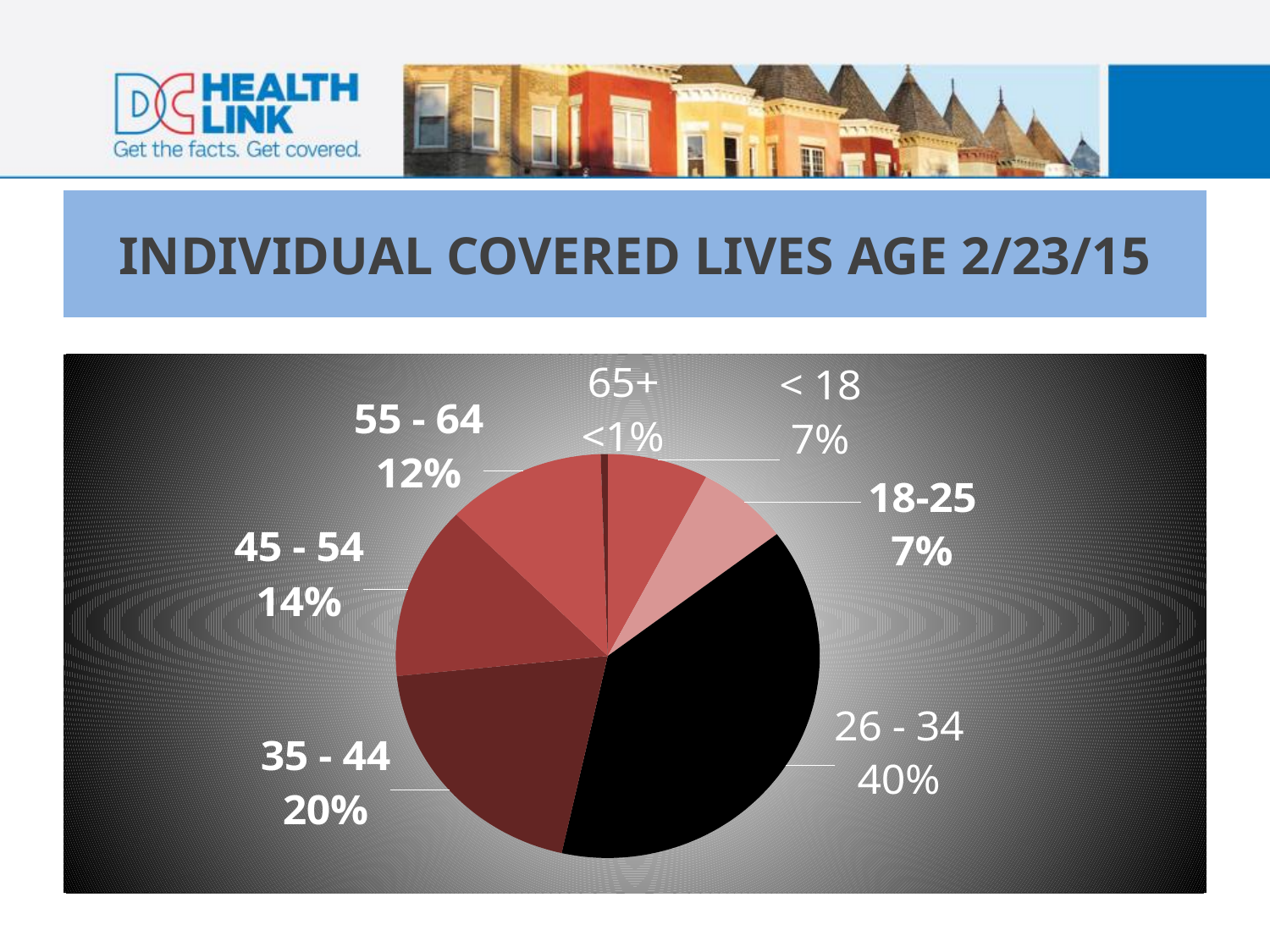
What is the title of the slide containing the pie chart? INDIVIDUAL COVERED LIVES AGE 2/23/15 What share of individual covered lives is in the 45 - 54 age group? 14% Which age group has a larger share, 45 - 54 or 55 - 64? 45 - 54 What share of individual covered lives is in the 26 - 34 age group? 40% What share of individual covered lives is in the 55 - 64 age group? 12% What is the difference in percentage points between the 26 - 34 and 35 - 44 age groups? 20 Which age group has the largest share of individual covered lives? 26 - 34 What kind of chart is shown on the slide? pie chart Which age group has the smallest share of individual covered lives? 65+ What share of individual covered lives is in the 35 - 44 age group? 20% How many age groups are shown in the pie chart? 7 What share of individual covered lives is in the 65+ age group? <1%